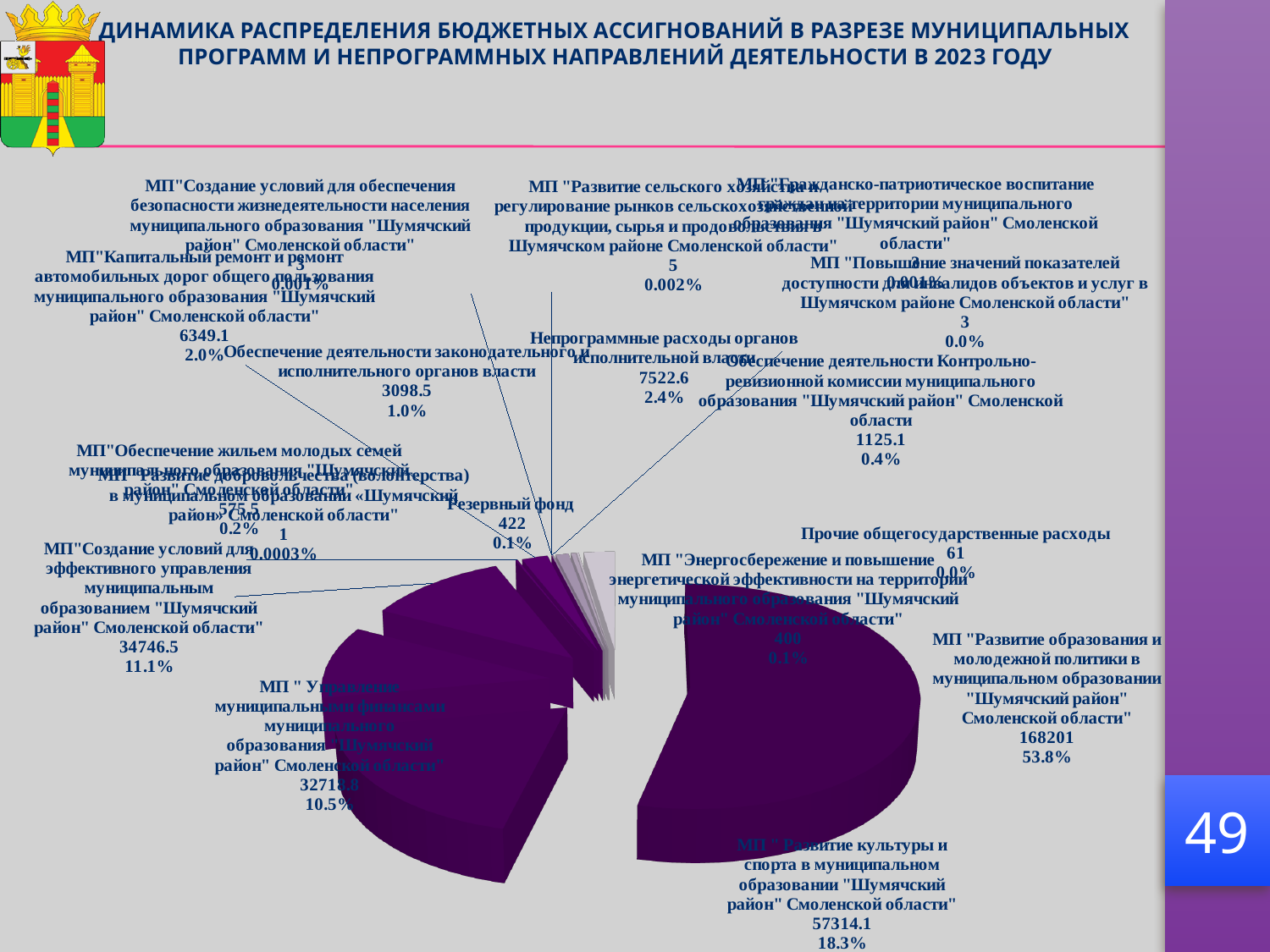
What is the value shown for МП "Развитие культуры и спорта в муниципальном образовании "Шумячский район" Смоленской области"? 57314.1 What is the value shown for Прочие общегосударственные расходы? 61 What share of the pie does МП "Создание условий для эффективного управления муниципальным образованием" have? 11.1% What share of the pie does МП "Развитие культуры и спорта" have? 18.3% What is the value shown for Непрограммные расходы органов исполнительной власти? 7522.6 Which category has the smallest value in the pie? МП "Развитие добровольчества (волонтерства) в муниципальном образовании «Шумячский район» Смоленской области" Which category has the largest share of the pie? МП "Развитие образования и молодежной политики в муниципальном образовании "Шумячский район" Смоленской области" Which is larger: the value for Непрограммные расходы органов исполнительной власти or the value for МП "Капитальный ремонт и ремонт автомобильных дорог"? Непрограммные расходы органов исполнительной власти What share of the pie does МП "Развитие образования и молодежной политики" have? 53.8% What is the value shown for Резервный фонд? 422 What kind of chart is shown on the slide? pie chart What is the difference between the values for МП "Развитие образования и молодежной политики" and МП "Развитие культуры и спорта"? 110886.9